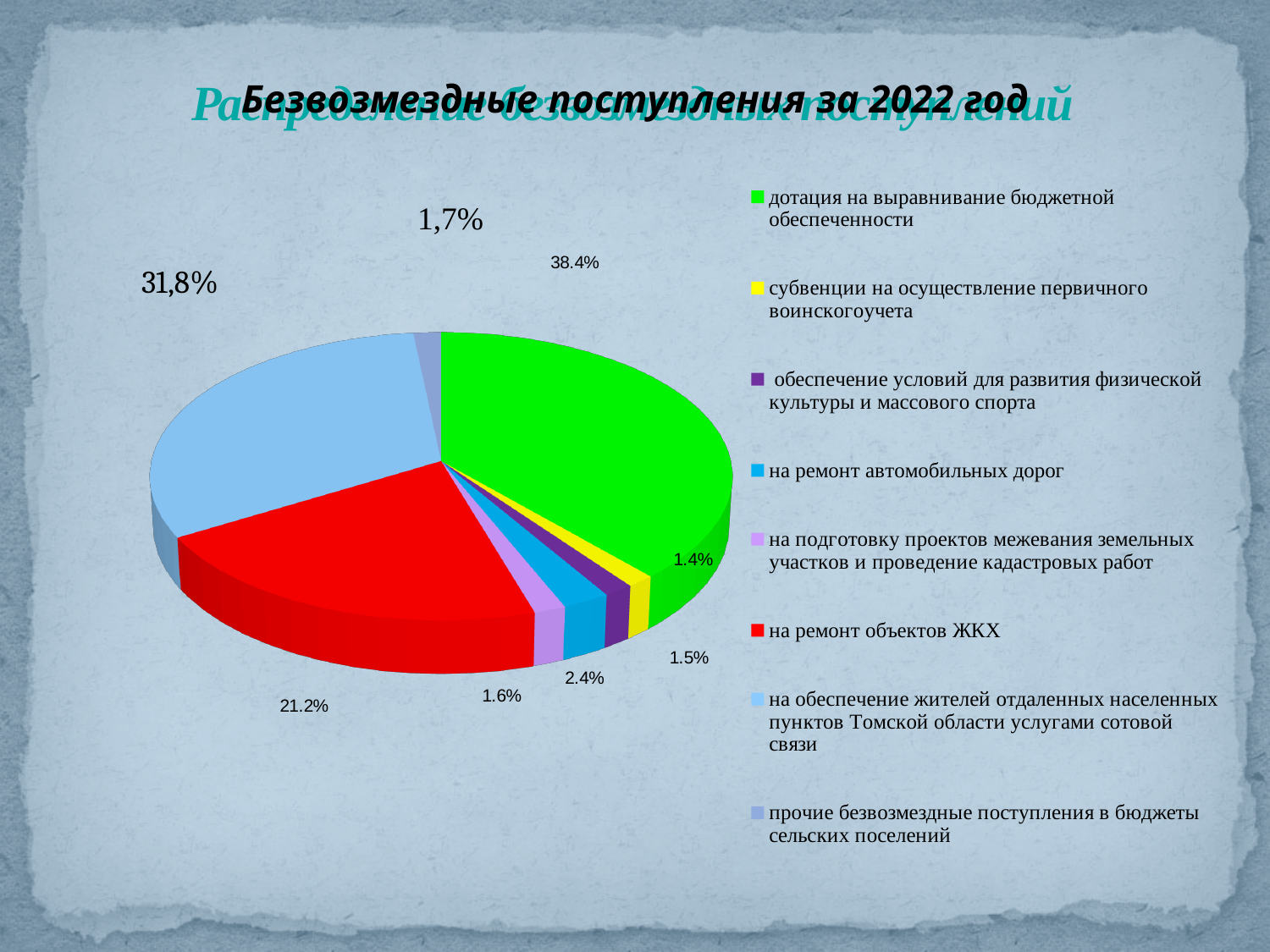
What is the bold title of the chart on the slide? Безвозмездные поступления за 2022 год Which category has the largest slice of the pie? дотация на выравнивание бюджетной обеспеченности Which slice is larger: 'на ремонт объектов ЖКХ' or 'на обеспечение жителей отдаленных населенных пунктов Томской области услугами сотовой связи'? на обеспечение жителей отдаленных населенных пунктов Томской области услугами сотовой связи What share is shown for 'прочие безвозмездные поступления в бюджеты сельских поселений'? 1,7% What share is shown for 'на обеспечение жителей отдаленных населенных пунктов Томской области услугами сотовой связи'? 31,8% What kind of chart is shown on the slide? pie chart By how many percentage points does the 'дотация на выравнивание бюджетной обеспеченности' slice exceed the 'на ремонт объектов ЖКХ' slice? 17.2 percentage points What colour is the slice for 'на ремонт объектов ЖКХ'? red How many categories does the legend of the pie chart list? 8 What share of the pie is labelled for 'дотация на выравнивание бюджетной обеспеченности'? 38.4% What share is shown for 'на ремонт автомобильных дорог'? 2.4% What share of the pie is labelled for 'на ремонт объектов ЖКХ'? 21.2%